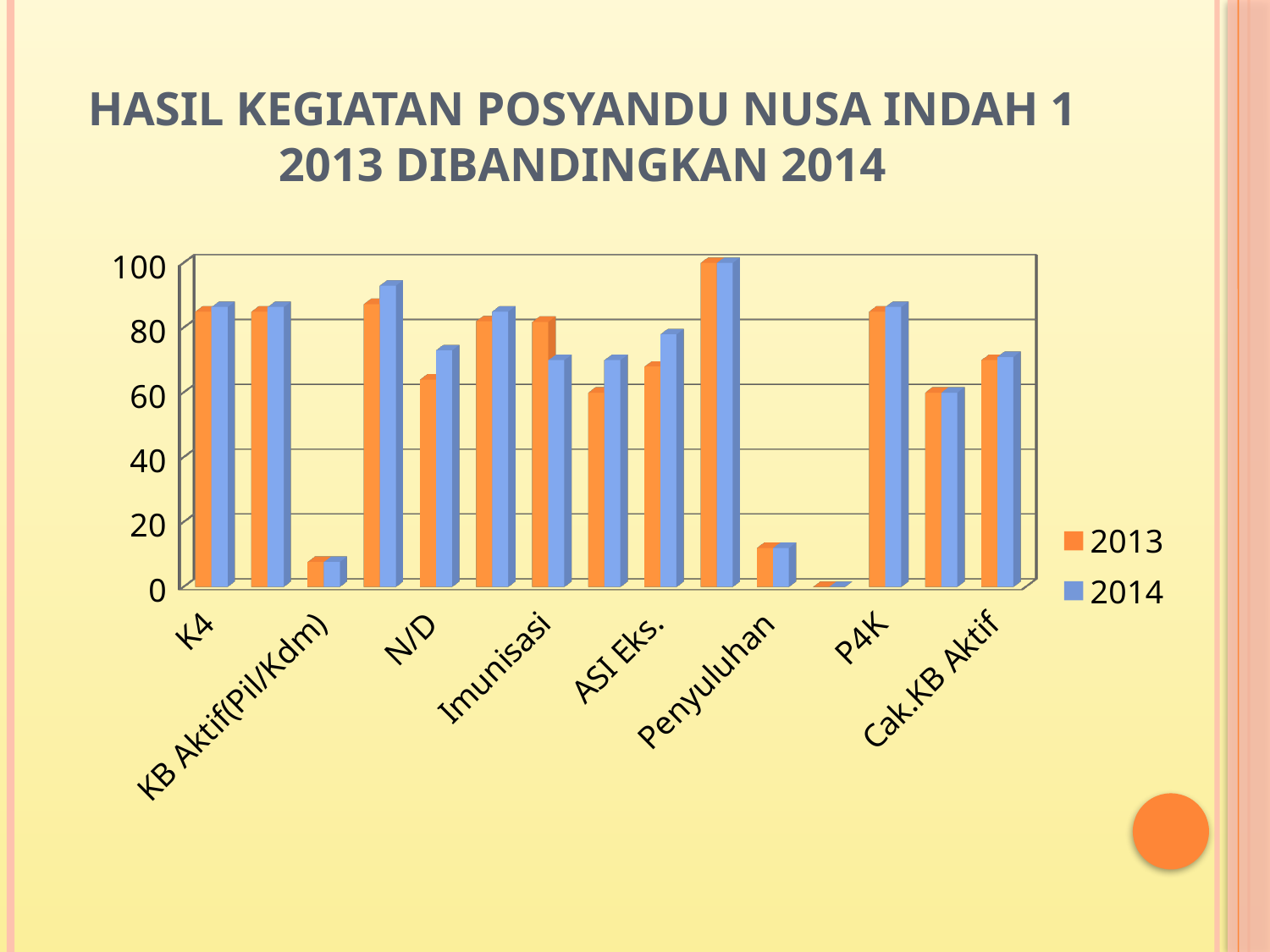
For Imunisasi, which year has the larger value, 2013 or 2014? 2013 Is the 2013 value for K4 greater or less than 80? greater Is the 2013 value for KB Aktif(Pil/Kdm) greater or less than 20? less What are the two series named in the legend? 2013 and 2014 For N/D, which year has the larger value, 2013 or 2014? 2014 Is the 2013 value for Penyuluhan greater or less than 20? less What kind of chart is shown on the slide? bar chart How many series does the legend list? 2 Which colour represents the 2014 series? blue